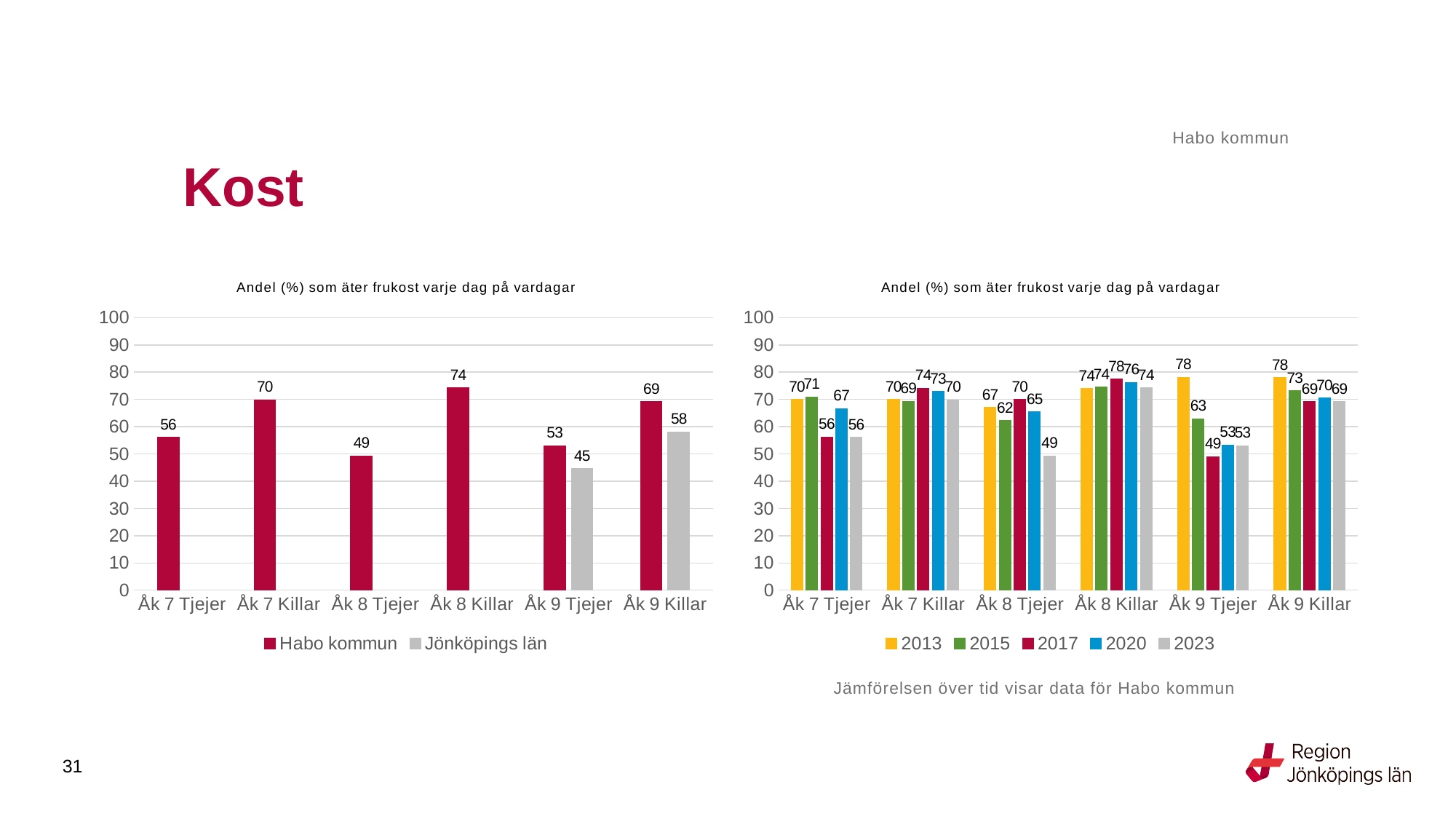
In the left chart, how many series does the legend list? 2 In the right chart, what is the value for 2020 for Åk 8 Tjejer? 65 In the left chart, what is the value for Jönköpings län for Åk 9 Tjejer? 45 In the right chart, what is the value for 2017 for Åk 9 Tjejer? 49 In the right chart, how many categories are shown on the x axis? 6 In the right chart, which is larger for Åk 7 Tjejer: the value for 2015 or the value for 2023? 2015 In the right chart, which year has the highest value for Åk 8 Killar? 2017 In the left chart, what is the difference between Habo kommun and Jönköpings län for Åk 9 Killar? 11 In the left chart, which category has the lowest value for Habo kommun? Åk 8 Tjejer In the left chart, what is the value for Habo kommun for Åk 8 Killar? 74 What kind of chart is the left chart? Bar chart In the right chart, how many series does the legend list? 5